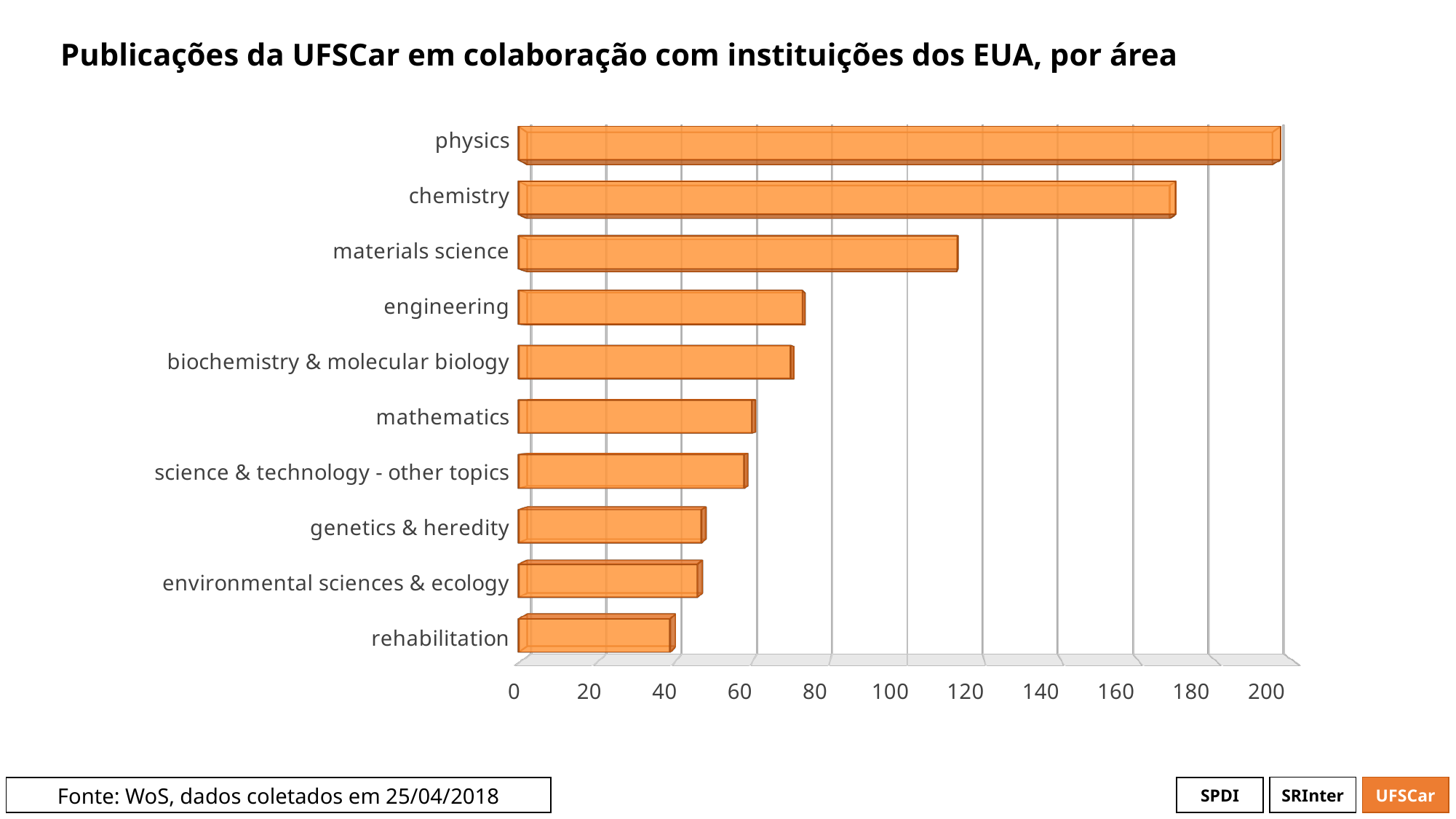
Is the value for chemistry greater or less than 160? greater Is the value for genetics & heredity greater or less than 60? less How many areas (categories) are plotted in the chart? 10 Which has more publications, physics or chemistry? physics Is the value for engineering greater or less than 80? less What kind of chart is shown on the slide? bar chart Which has more publications, materials science or engineering? materials science Which area has the highest number of publications? physics Which area has the lowest number of publications? rehabilitation What is the title of the chart? Publicações da UFSCar em colaboração com instituições dos EUA, por área